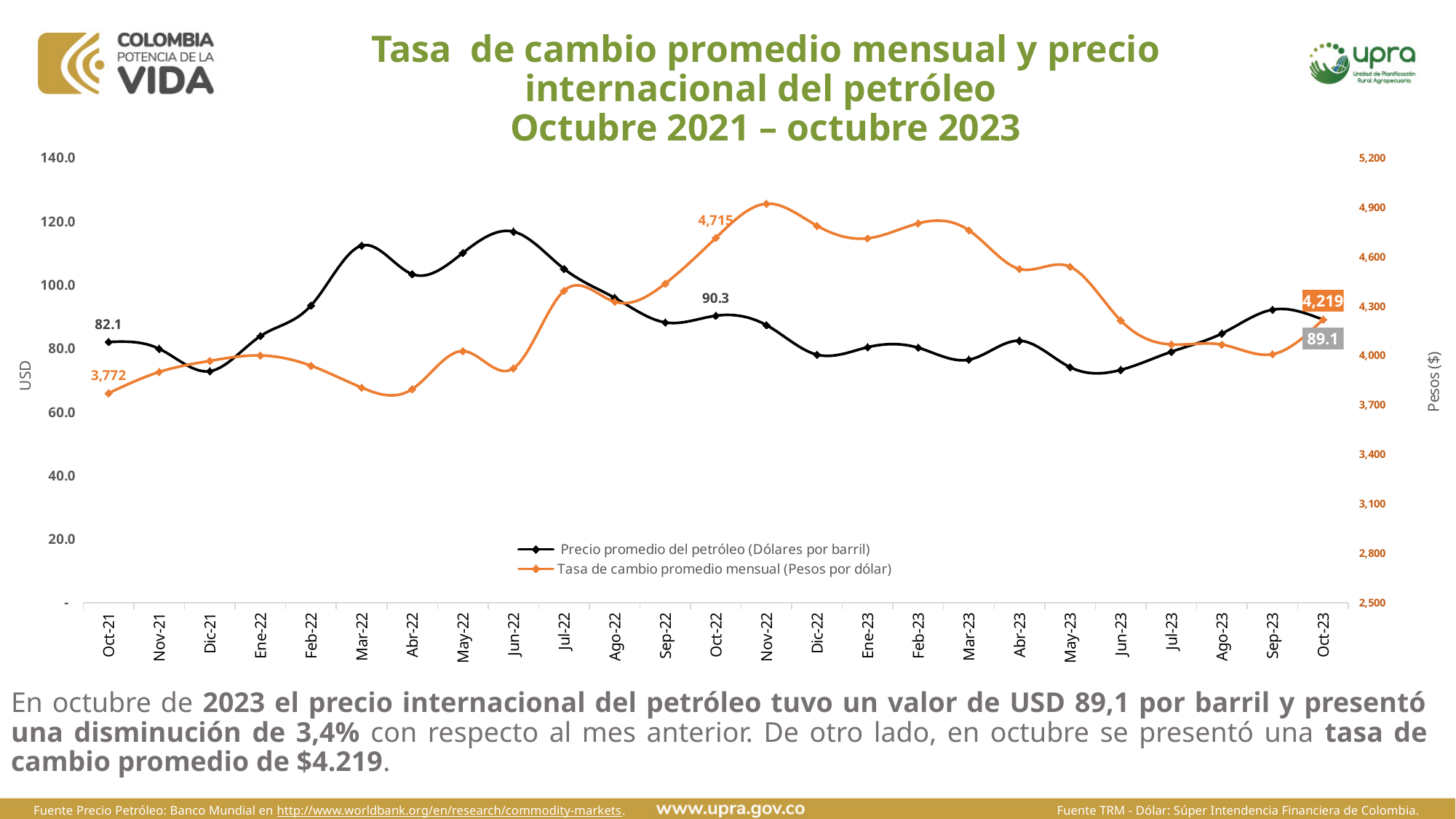
Which month has the highest exchange rate (Tasa de cambio promedio mensual)? Nov-22 Which month has the highest average oil price? Jun-22 Is the average oil price for Mar-22 greater or less than 100.0? greater By how much did the exchange rate in Oct-22 (4,715) exceed the exchange rate in Oct-23 (4,219)? 496 What is the monthly average exchange rate shown for Oct-21? 3,772 What kind of chart is shown on the slide? Line chart What is the difference between the oil price in Oct-22 (90.3) and in Oct-21 (82.1)? 8.2 How many series does the legend list? 2 What is the average oil price (Dólares por barril) shown for Oct-21? 82.1 Is the exchange rate for Nov-22 greater or less than 4,600? greater What is the monthly average exchange rate (Pesos por dólar) shown for Oct-22? 4,715 What is the average oil price shown for Oct-23? 89.1